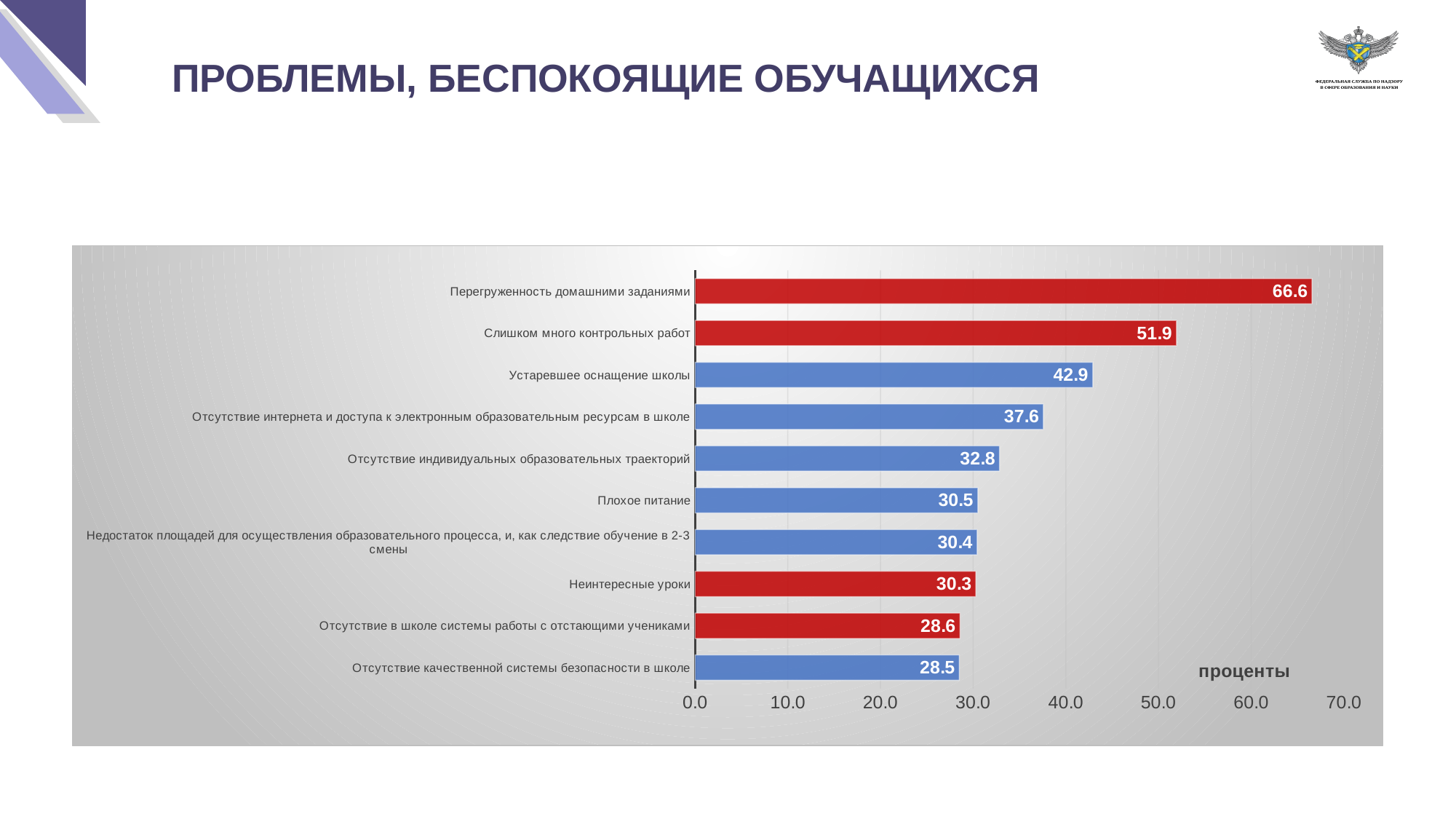
What is the value for «Перегруженность домашними заданиями»? 66.6 What is the value for «Плохое питание»? 30.5 Which category has the lowest value? Отсутствие качественной системы безопасности в школе What kind of chart is shown on the slide? bar chart Which is larger: the value for «Отсутствие интернета и доступа к электронным образовательным ресурсам в школе» or for «Отсутствие индивидуальных образовательных траекторий»? Отсутствие интернета и доступа к электронным образовательным ресурсам в школе Is the value for «Слишком много контрольных работ» greater or less than 50.0? greater What is the value for «Отсутствие в школе системы работы с отстающими учениками»? 28.6 What is the label shown on the horizontal axis of the chart? проценты What is the difference between the values for «Перегруженность домашними заданиями» and «Слишком много контрольных работ»? 14.7 What is the value for «Устаревшее оснащение школы»? 42.9 How many categories are shown in the chart? 10 Which category has the highest value? Перегруженность домашними заданиями